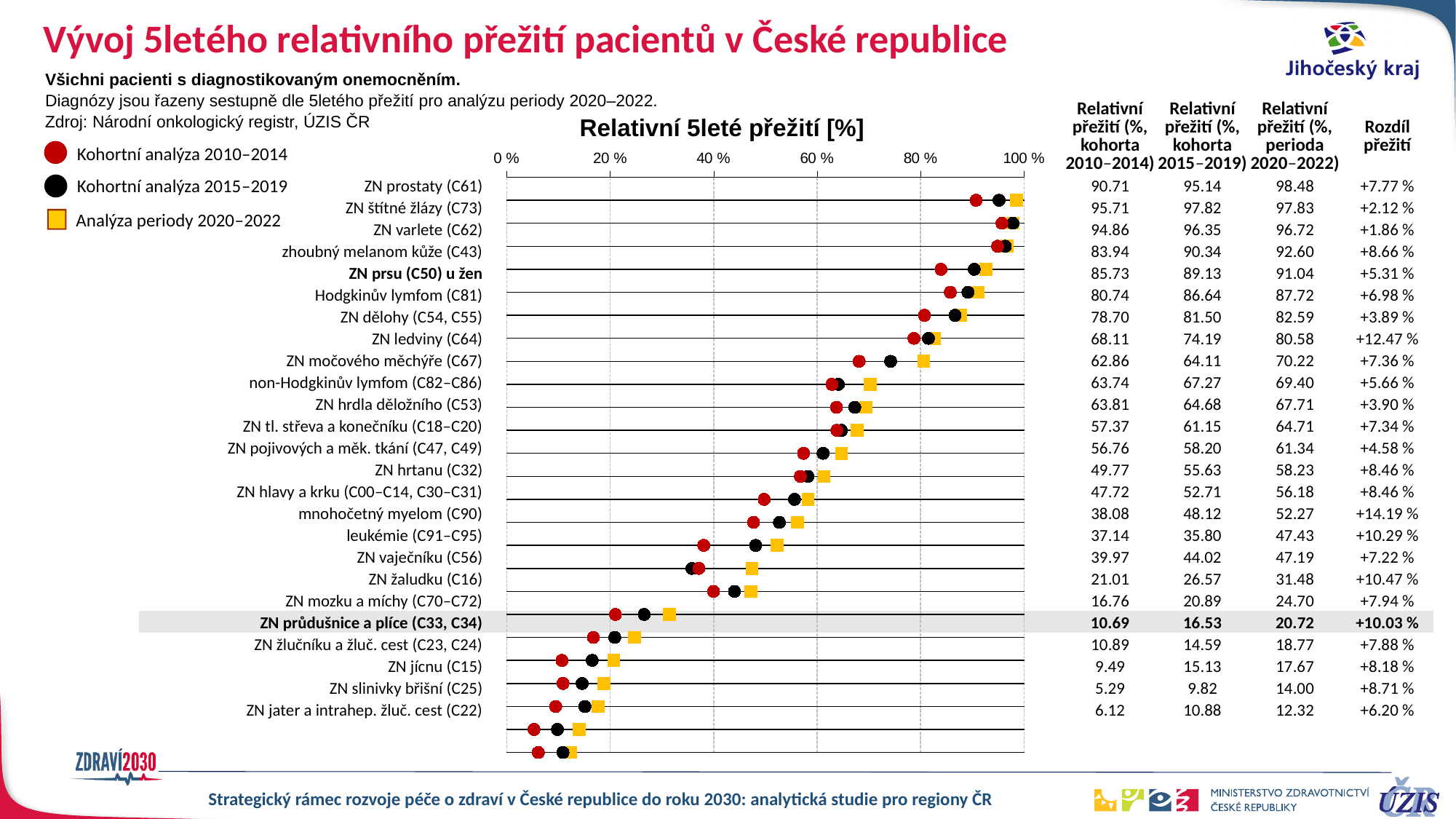
What is the difference between the 2015–2019 cohort value and the 2010–2014 cohort value for ZN prostaty (C61)? 4.43 Which diagnosis has the highest relative 5-year survival in the period analysis 2020–2022? ZN prostaty (C61) What is the title of the chart? Relativní 5leté přežití [%] Which diagnosis has the largest 'Rozdíl přežití' value? mnohočetný myelom (C90) Which diagnosis has the lowest relative 5-year survival in the period analysis 2020–2022? ZN jater a intrahep. žluč. cest (C22) What is the relative 5-year survival for ZN žaludku (C16) in the cohort analysis 2015–2019? 26.57 What is the relative 5-year survival for ZN prostaty (C61) in the period analysis 2020–2022? 98.48 For leukémie (C91–C95), which is larger: the cohort 2010–2014 value or the cohort 2015–2019 value? Kohortní analýza 2010–2014 What is the relative 5-year survival for ZN průdušnice a plíce (C33, C34) in the cohort analysis 2010–2014? 10.69 How many series does the legend list? 3 How many diagnoses are listed on the chart? 25 Is the period 2020–2022 value for ZN mozku a míchy (C70–C72) greater or less than 40 %? less